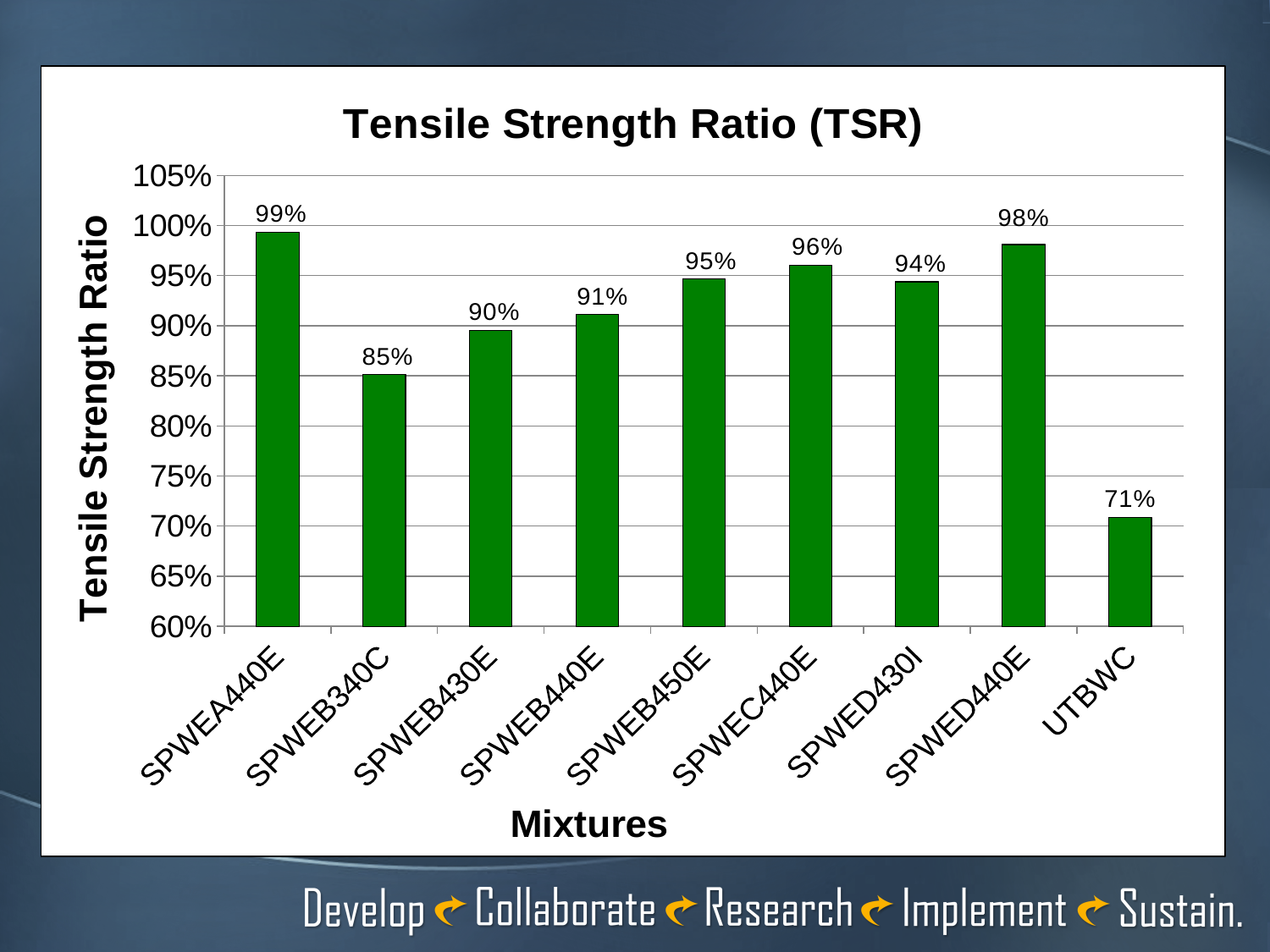
What is the title of the chart? Tensile Strength Ratio (TSR) Which has a higher Tensile Strength Ratio, SPWEB450E or SPWED430I? SPWEB450E Which mixture has the lowest Tensile Strength Ratio? UTBWC What type of chart is shown on the slide? bar chart What is the Tensile Strength Ratio for SPWEB340C? 85% What is the Tensile Strength Ratio for SPWED440E? 98% What is the difference between the Tensile Strength Ratio of SPWEA440E and UTBWC? 28% What is the difference between the Tensile Strength Ratio of SPWEC440E and SPWEB430E? 6% How many mixtures are shown on the chart? 9 Is the Tensile Strength Ratio for SPWEB440E greater or less than 90%? greater What is the Tensile Strength Ratio for UTBWC? 71% Which mixture has the highest Tensile Strength Ratio? SPWEA440E